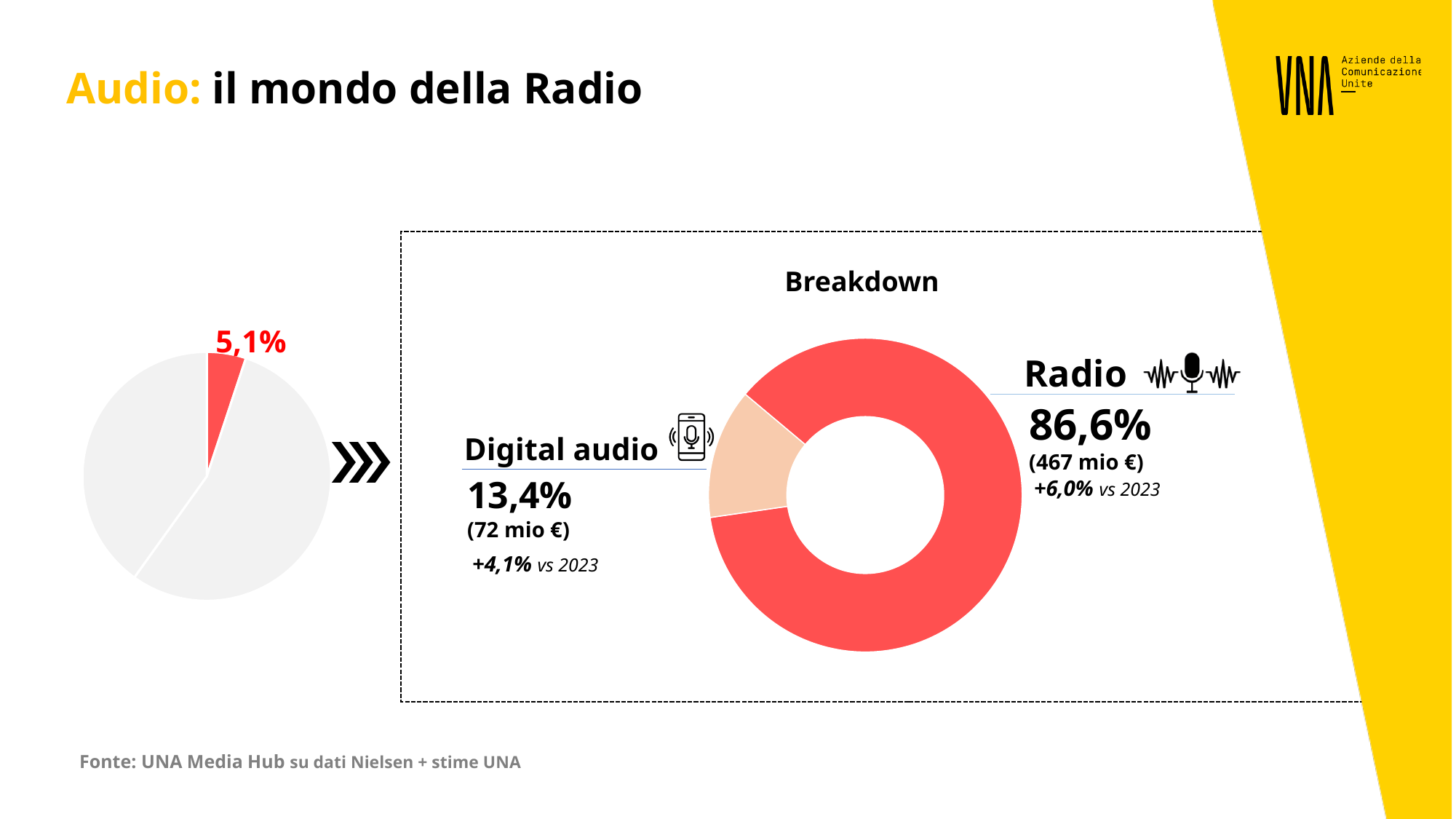
In the Breakdown chart, how many segments are shown? 2 In the Breakdown chart, what is the value in mio € shown for Radio? 467 mio € In the Breakdown chart, what is the change vs 2023 shown for Radio? +6,0% In the Breakdown chart, what share does Radio account for? 86,6% What kind of chart is the Breakdown chart? Donut chart In the Breakdown chart, what is the value in mio € shown for Digital audio? 72 mio € In the pie chart on the left of the slide, what percentage is labelled on the red slice? 5,1% In the Breakdown chart, which segment is the smallest? Digital audio In the Breakdown chart, which segment is the largest? Radio In the Breakdown chart, what is the change vs 2023 shown for Digital audio? +4,1% In the Breakdown chart, what share does Digital audio account for? 13,4% In the Breakdown chart, what is the difference in percentage points between Radio and Digital audio? 73,2